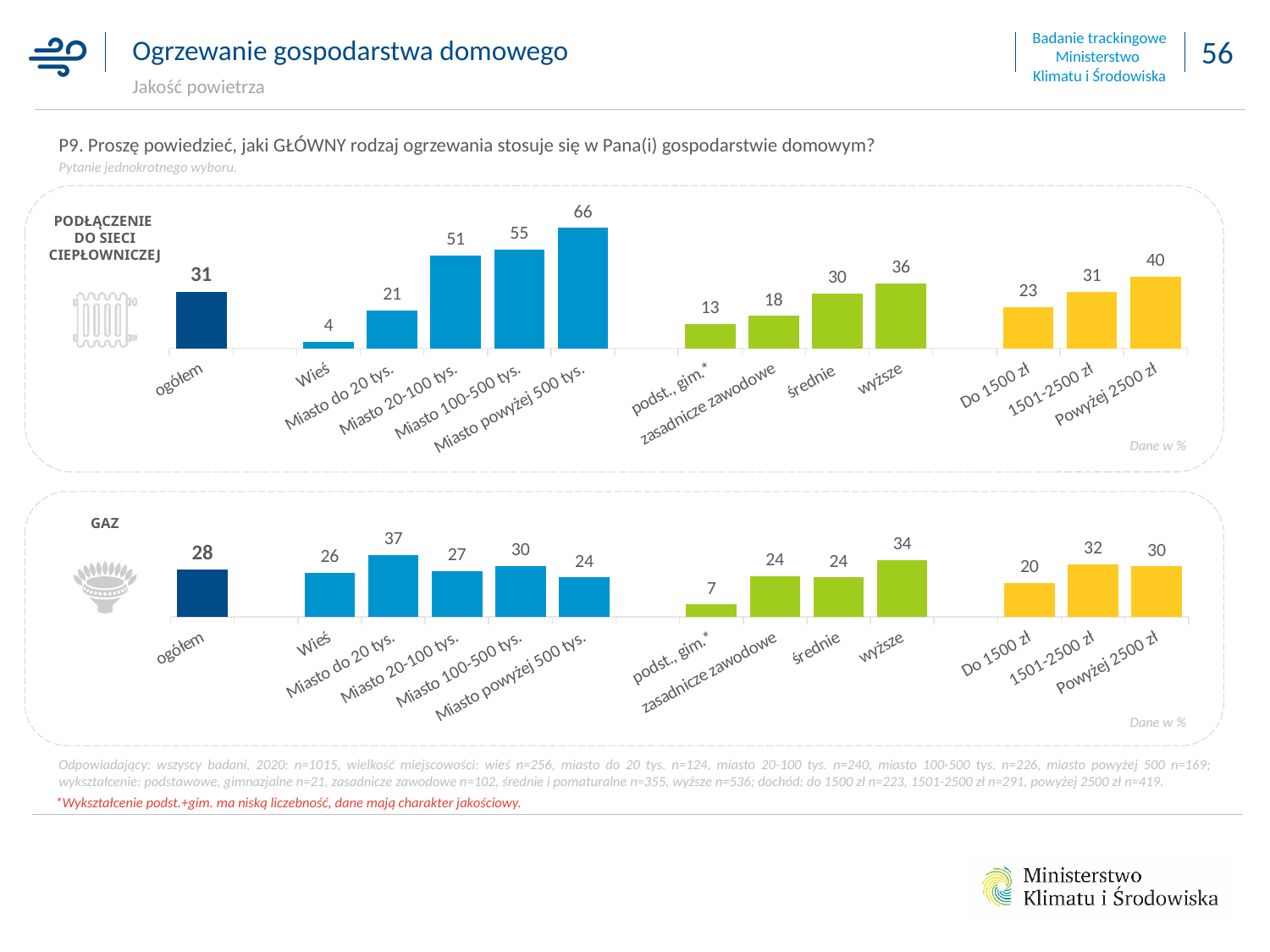
In the 'PODŁĄCZENIE DO SIECI CIEPŁOWNICZEJ' chart, what is the value for 'ogółem'? 31 In the 'PODŁĄCZENIE DO SIECI CIEPŁOWNICZEJ' chart, which category has the highest value? Miasto powyżej 500 tys. In the 'GAZ' chart, what is the value for 'podst., gim.'? 7 In the 'GAZ' chart, what is the difference between 'wyższe' and 'podst., gim.'? 27 In the 'PODŁĄCZENIE DO SIECI CIEPŁOWNICZEJ' chart, what is the difference between 'Powyżej 2500 zł' and 'Do 1500 zł'? 17 In the 'GAZ' chart, which category has the highest value? Miasto do 20 tys. In the 'GAZ' chart, what is the value for 'Miasto do 20 tys.'? 37 In the 'PODŁĄCZENIE DO SIECI CIEPŁOWNICZEJ' chart, what is the value for 'Miasto powyżej 500 tys.'? 66 What type of chart is the 'GAZ' chart? bar chart In the 'PODŁĄCZENIE DO SIECI CIEPŁOWNICZEJ' chart, do the values rise or fall from 'Wieś' to 'Miasto powyżej 500 tys.'? rise In the 'PODŁĄCZENIE DO SIECI CIEPŁOWNICZEJ' chart, which category has the lowest value? Wieś In the 'GAZ' chart, which is larger: 'wyższe' or 'średnie'? wyższe